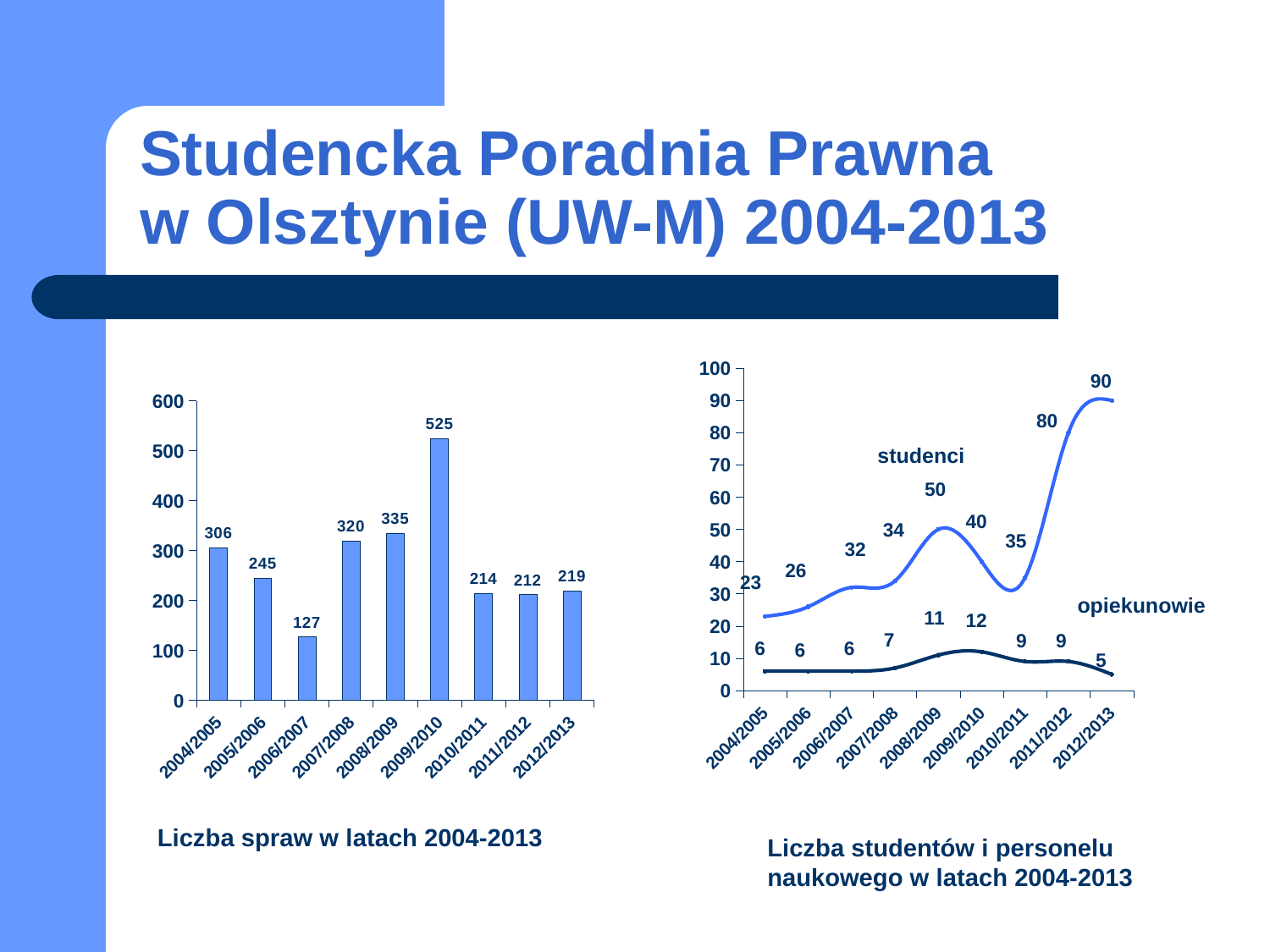
In the right chart (Liczba studentów i personelu naukowego), which year has the highest value for studenci? 2012/2013 What kind of chart is the left chart (Liczba spraw w latach 2004-2013)? bar chart In the left chart (Liczba spraw w latach 2004-2013), what is the difference between the values for 2008/2009 and 2007/2008? 15 What kind of chart is the right chart (Liczba studentów i personelu naukowego)? line chart In the left chart (Liczba spraw w latach 2004-2013), which year has the lowest value? 2006/2007 In the right chart (Liczba studentów i personelu naukowego), what is the value for opiekunowie in 2009/2010? 12 In the left chart (Liczba spraw w latach 2004-2013), which is larger, the value for 2004/2005 or 2005/2006? 2004/2005 In the right chart (Liczba studentów i personelu naukowego), how many series are plotted? 2 In the left chart (Liczba spraw w latach 2004-2013), what is the value for 2009/2010? 525 In the right chart (Liczba studentów i personelu naukowego), what is the difference between studenci and opiekunowie in 2008/2009? 39 In the right chart (Liczba studentów i personelu naukowego), what is the value for studenci in 2012/2013? 90 In the left chart (Liczba spraw w latach 2004-2013), how many years are shown on the x axis? 9